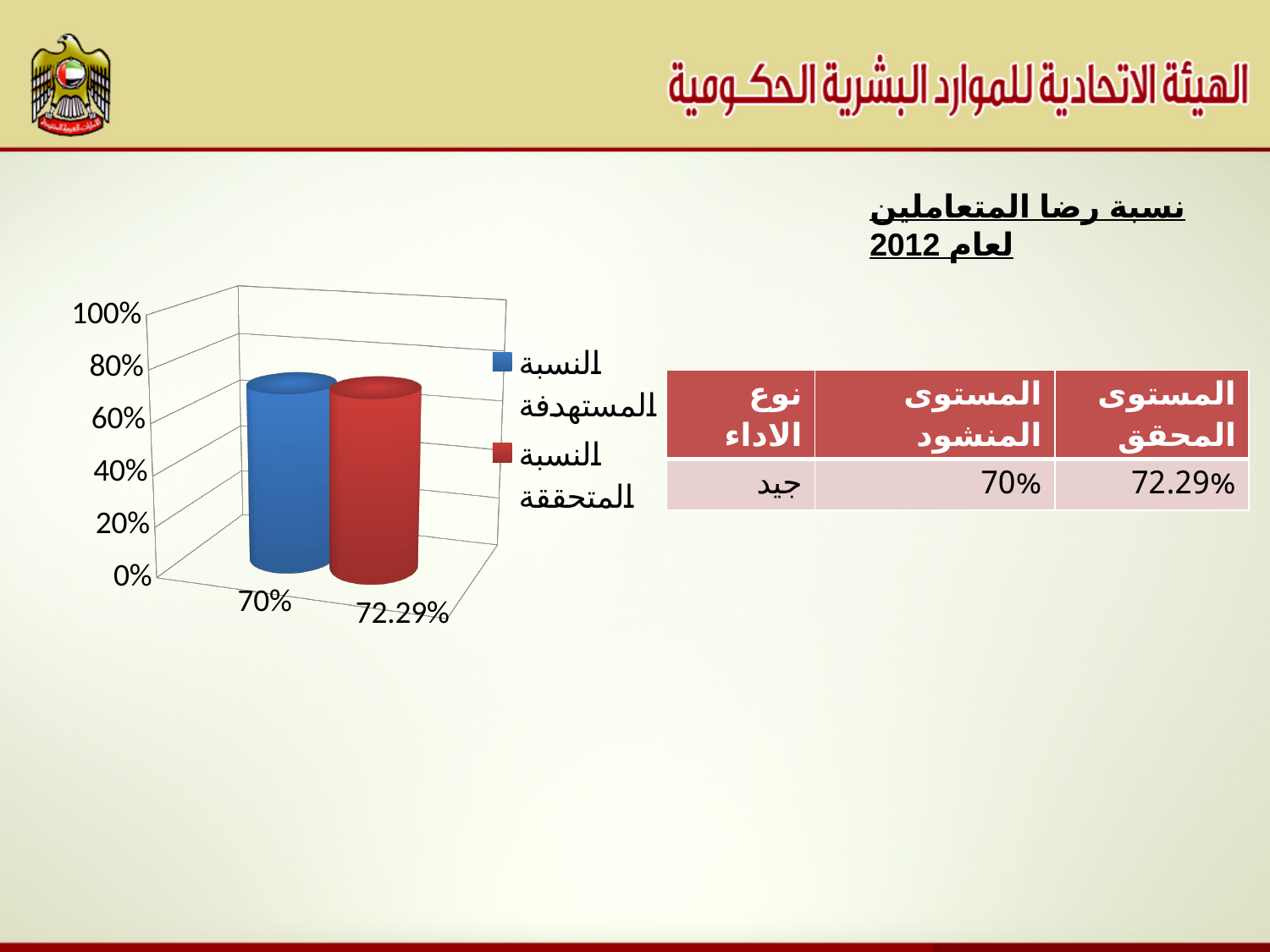
Is the value of the blue bar greater or less than 60%? greater What is the value of the blue bar (النسبة المستهدفة)? 70% How many series does the chart legend list? 2 Which series has the higher value, النسبة المستهدفة or النسبة المتحققة? النسبة المتحققة What is the value of the red bar (النسبة المتحققة)? 72.29% What is the difference between the achieved value (72.29%) and the target value (70%)? 2.29% Which bar shows the lowest value? النسبة المستهدفة (70%) What is the highest tick value shown on the vertical axis? 100% What kind of chart is shown on the slide? bar chart How many bars are plotted in the chart? 2 What colour is the bar for النسبة المتحققة? red Is the value of the red bar greater or less than 80%? less